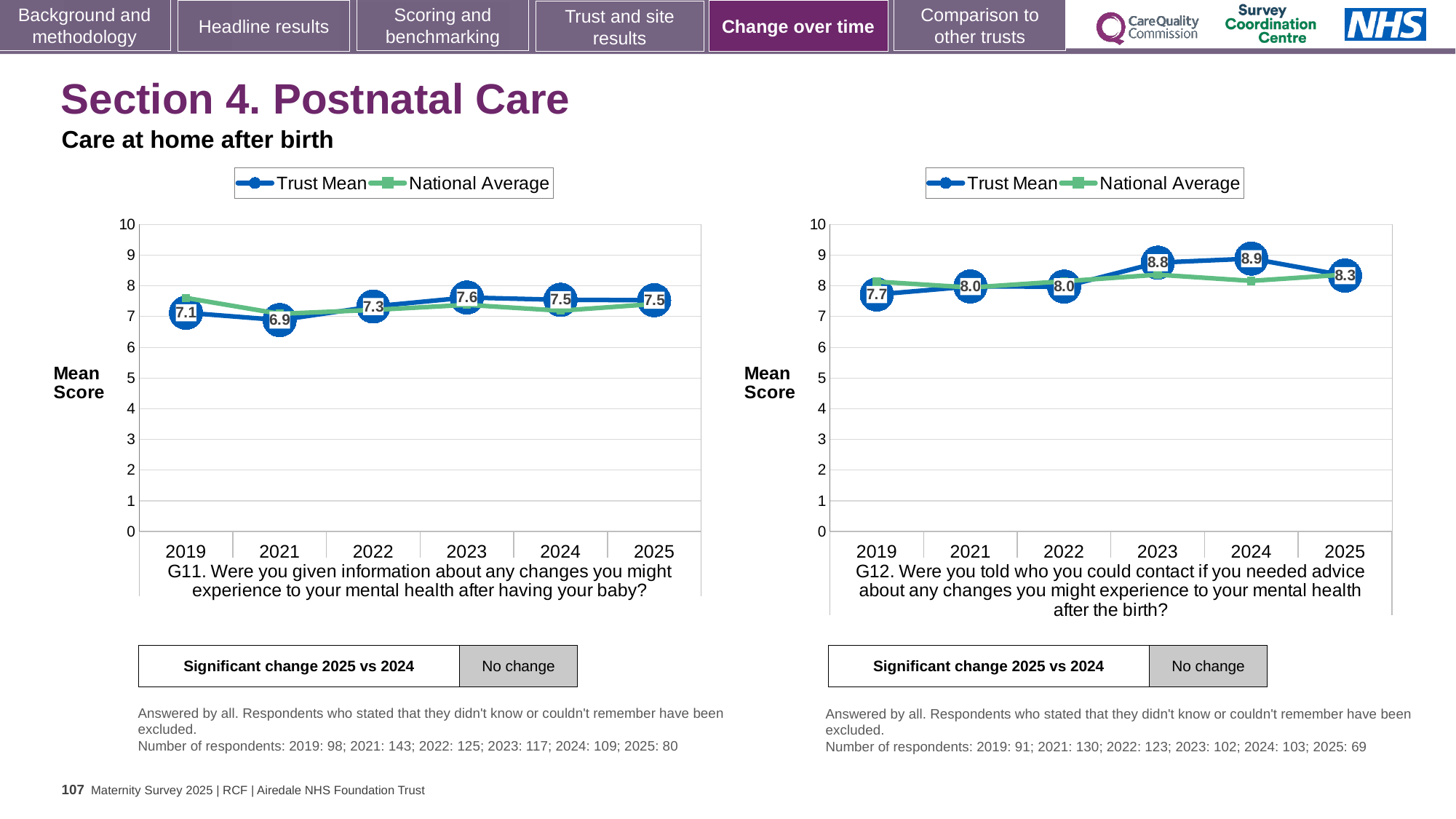
On the G12 chart (right), which year has the highest Trust Mean? 2024 What type of chart is the G11 chart (left)? line chart How many years are plotted on the x axis of the G11 chart (left)? 6 On the G12 chart (right), what is the Trust Mean for 2019? 7.7 On the G12 chart (right), what is the Trust Mean for 2024? 8.9 On the G11 chart (left), what is the Trust Mean for 2023? 7.6 On the G11 chart (left), what is the Trust Mean for 2021? 6.9 On the G11 chart (left), what is the difference between the Trust Mean in 2023 and in 2021? 0.7 On the G12 chart (right), is the Trust Mean for 2025 higher or lower than for 2024? lower How many series does the legend of the G12 chart (right) list? 2 On the G12 chart (right), what is the difference between the Trust Mean in 2024 and in 2025? 0.6 On the G11 chart (left), which year has the lowest Trust Mean? 2021